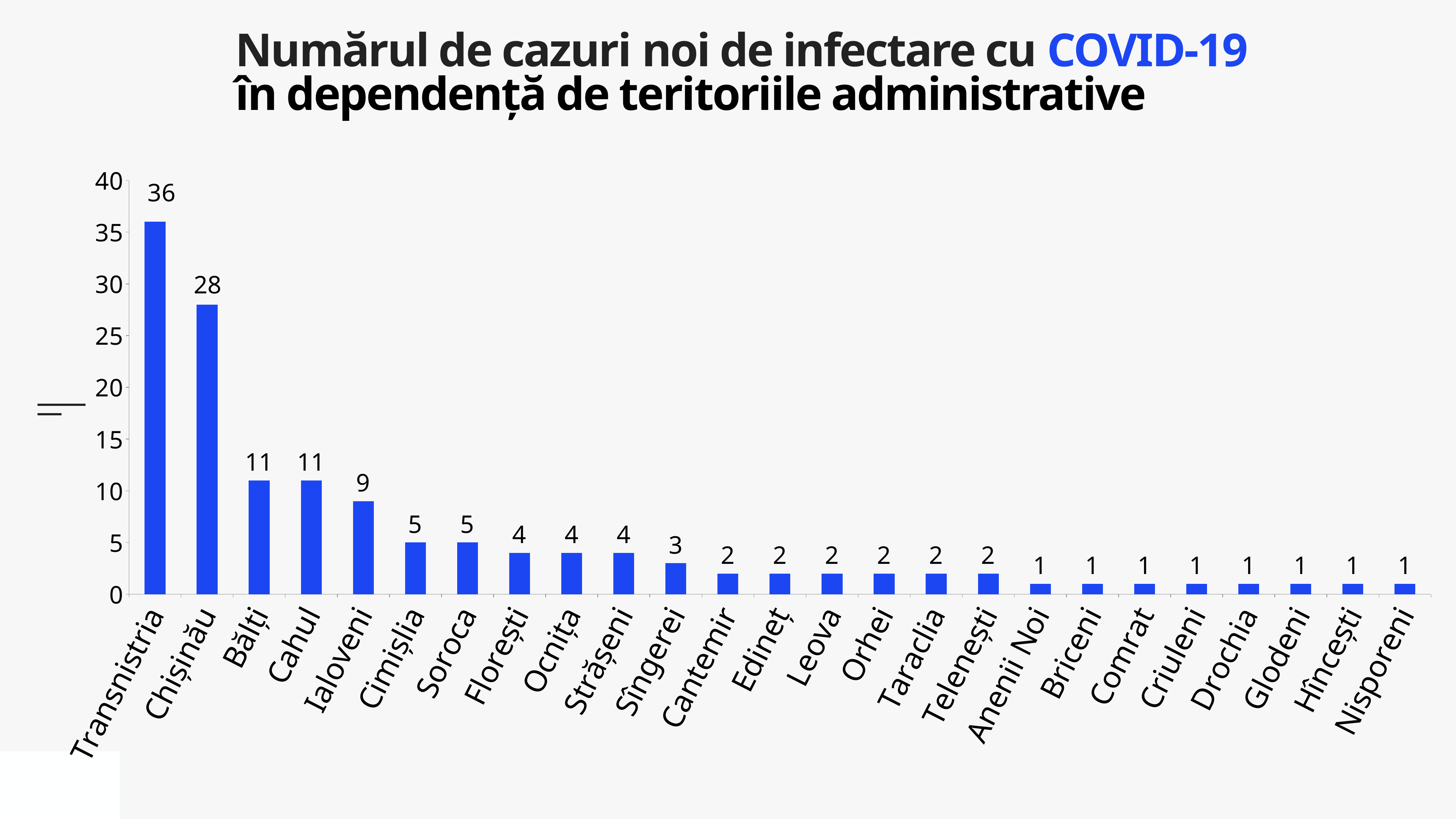
Which is larger, the value for Cimișlia or the value for Florești? Cimișlia What is the value for Ialoveni? 9 What is the value for Chișinău? 28 What is the value for Transnistria? 36 What is the difference between the values for Bălți and Ialoveni? 2 What is the value for Sîngerei? 3 Is the value for Chișinău greater or less than 25? greater Do the values rise or fall from left to right along the x axis? fall What is the difference between the values for Transnistria and Chișinău? 8 How many territories are shown on the x axis? 25 Which territory has the highest number of new cases? Transnistria What kind of chart is shown on the slide? bar chart